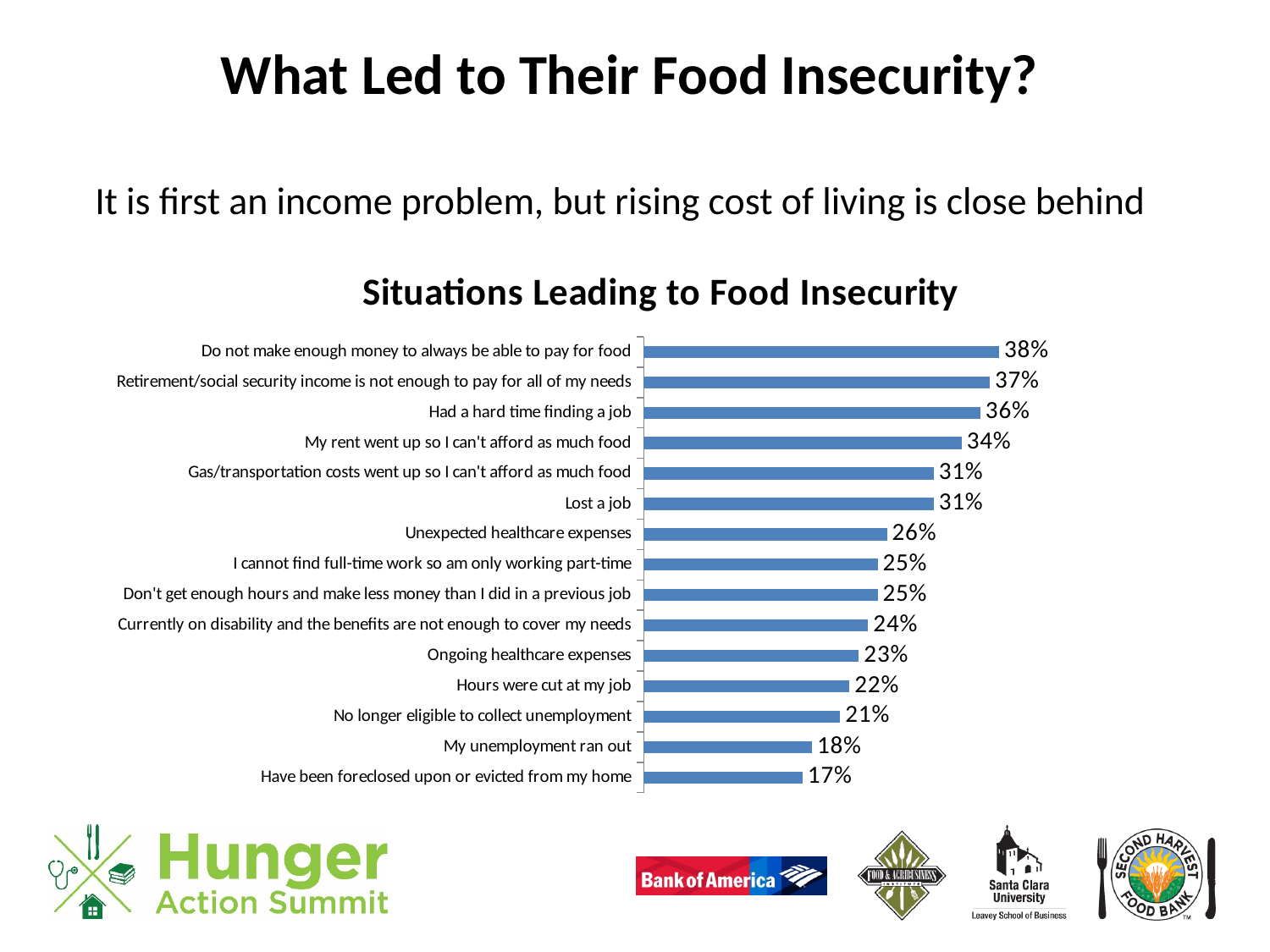
Which is larger: "Retirement/social security income is not enough to pay for all of my needs" or "Currently on disability and the benefits are not enough to cover my needs"? Retirement/social security income is not enough to pay for all of my needs What kind of chart is shown on the slide? Bar chart What is the value for "Lost a job"? 31% What is the value for "No longer eligible to collect unemployment"? 21% What is the value for "My unemployment ran out"? 18% What is the value for "Unexpected healthcare expenses"? 26% What is the difference between "My rent went up so I can't afford as much food" and "Ongoing healthcare expenses"? 11% Which category has the highest value? Do not make enough money to always be able to pay for food What is the title of the chart? Situations Leading to Food Insecurity Which category has the lowest value? Have been foreclosed upon or evicted from my home What is the difference between "Had a hard time finding a job" and "Hours were cut at my job"? 14% How many categories are shown in the chart? 15